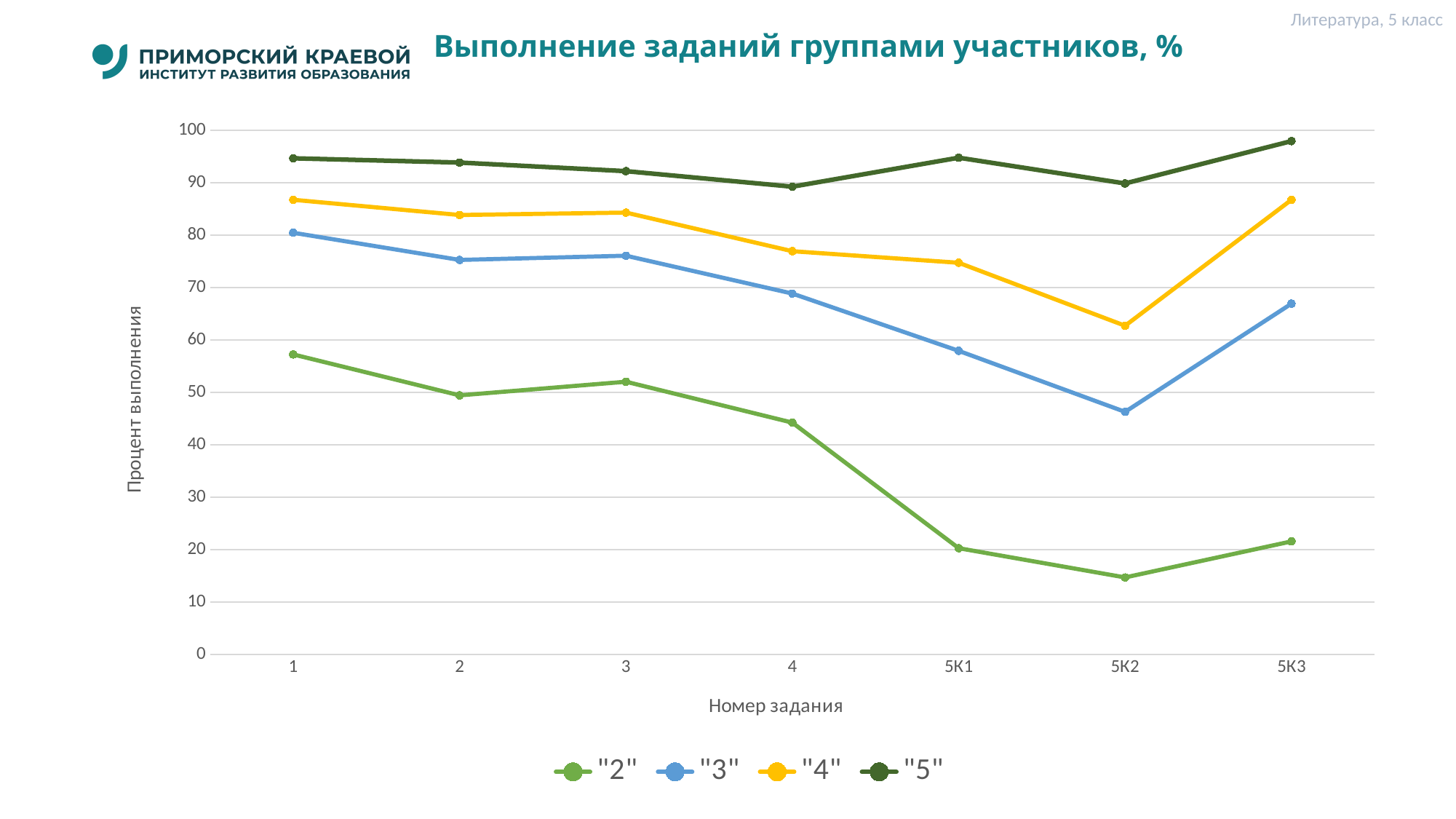
For which task is the value of the "5" series highest? 5К3 For which task is the value of the "2" series lowest? 5К2 At task 4, which series has the larger value: "4" or "3"? "4" For which task is the value of the "2" series highest? 1 How many task numbers are shown along the x axis? 7 For which task is the value of the "3" series lowest? 5К2 How many series does the legend list? 4 What kind of chart is shown on the slide? line chart Is the value for the "4" series at task 5К2 greater or less than 70? less Is the value for the "2" series at task 1 greater or less than 50? greater Does the "2" series rise or fall from task 1 to task 5К2? fall Is the value for the "3" series at task 5К2 greater or less than 50? less